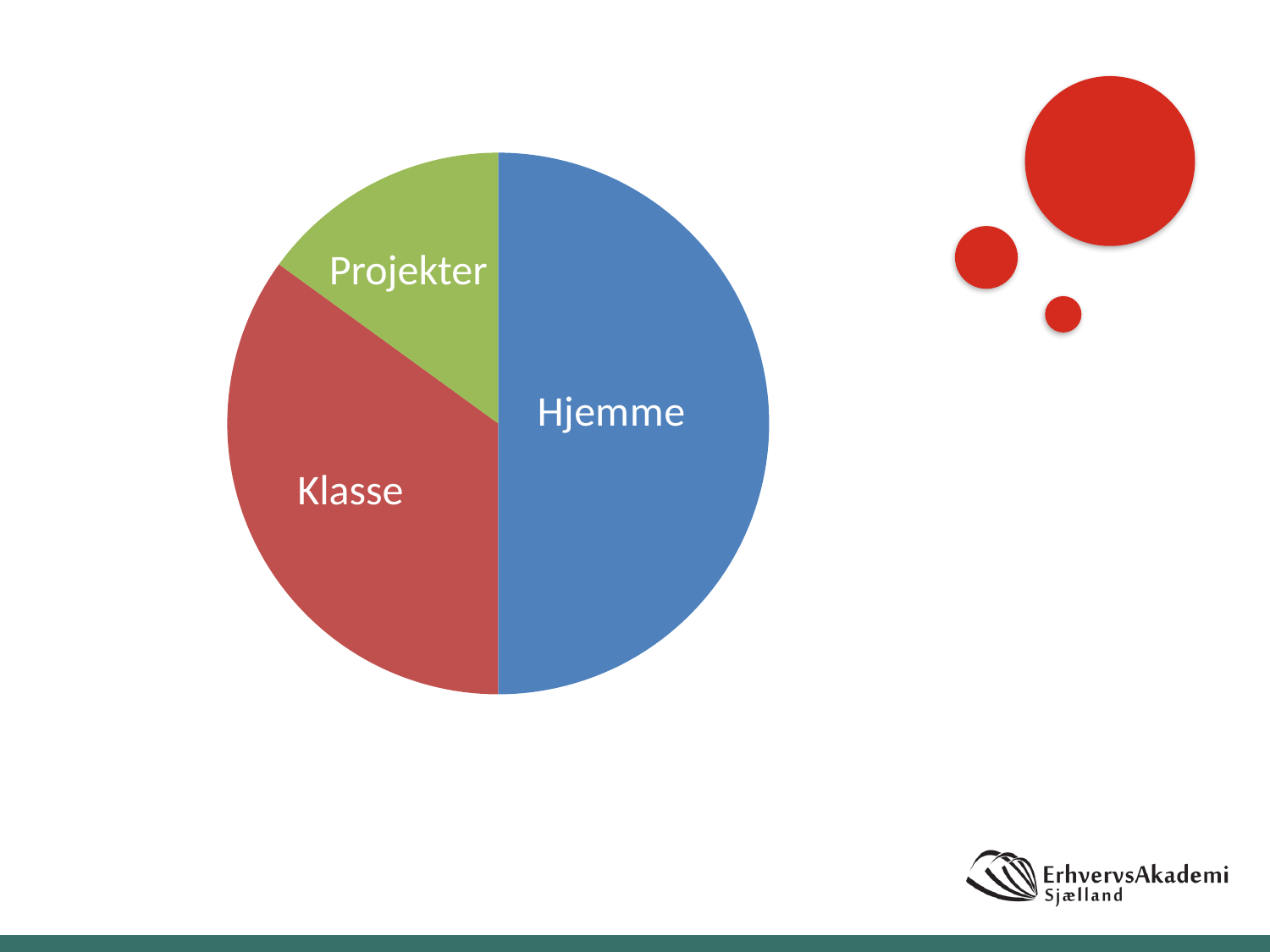
Which slice of the pie chart is the largest? Hjemme What colour is the Hjemme slice of the pie chart? blue Which slice is larger, Hjemme or Projekter? Hjemme What kind of chart is shown on the slide? pie chart How many slices does the pie chart have? 3 Which slice of the pie chart is green? Projekter Which slice is larger, Hjemme or Klasse? Hjemme Which slice is larger, Klasse or Projekter? Klasse Which slice of the pie chart is the smallest? Projekter